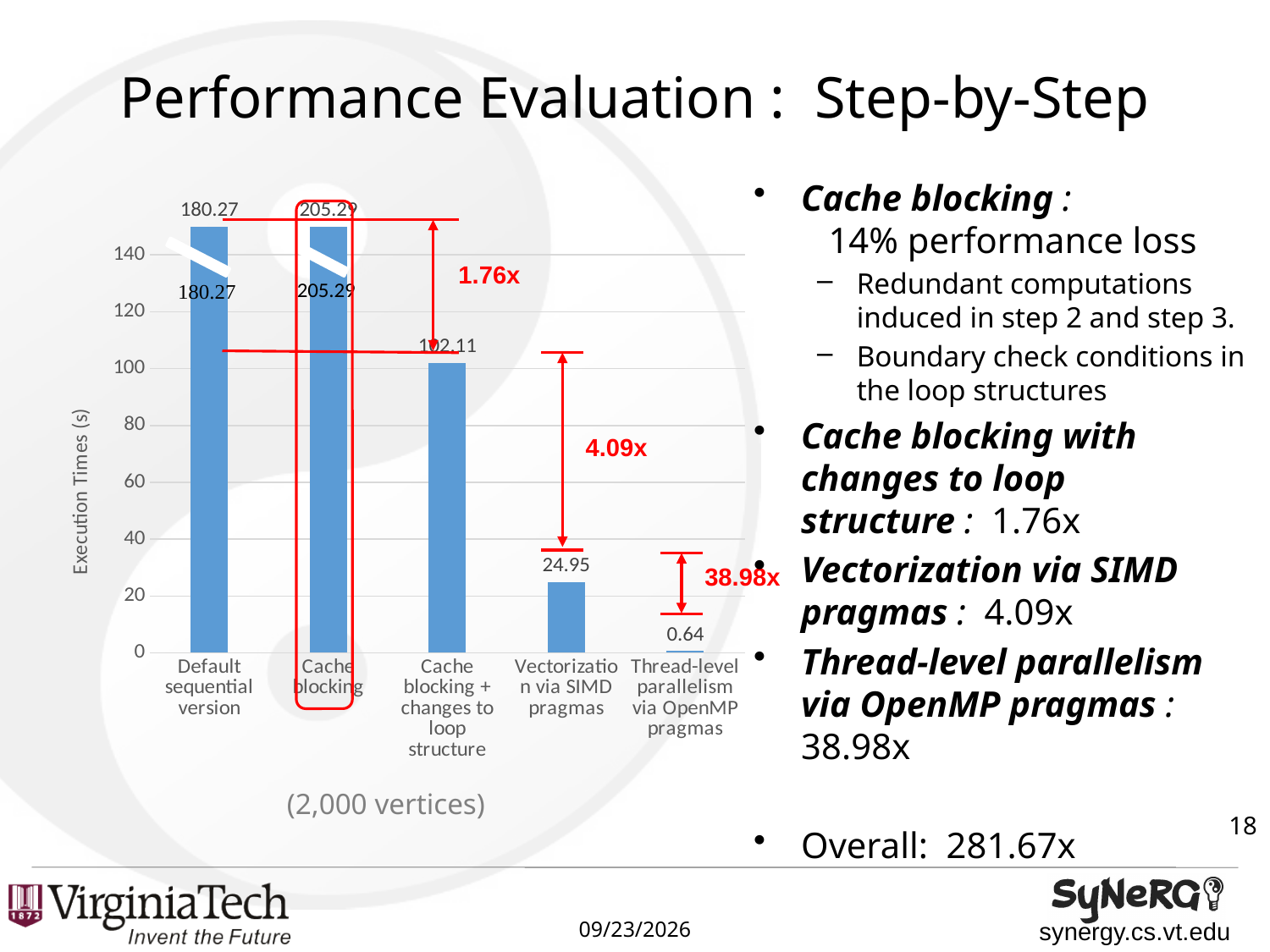
How many categories are shown on the x axis of the chart? 5 Which has a larger execution time, Cache blocking + changes to loop structure or Vectorization via SIMD pragmas? Cache blocking + changes to loop structure What is the execution time for Cache blocking? 205.29 Which category has the highest execution time? Cache blocking What is the execution time for Vectorization via SIMD pragmas? 24.95 What kind of chart is shown on the slide? Bar chart What is the difference in execution time between Cache blocking and the Default sequential version? 25.02 Which category has the lowest execution time? Thread-level parallelism via OpenMP pragmas What is the execution time for the Default sequential version? 180.27 What is the label of the y axis of the chart? Execution Times (s) What is the execution time for Cache blocking + changes to loop structure? 102.11 What is the execution time for Thread-level parallelism via OpenMP pragmas? 0.64